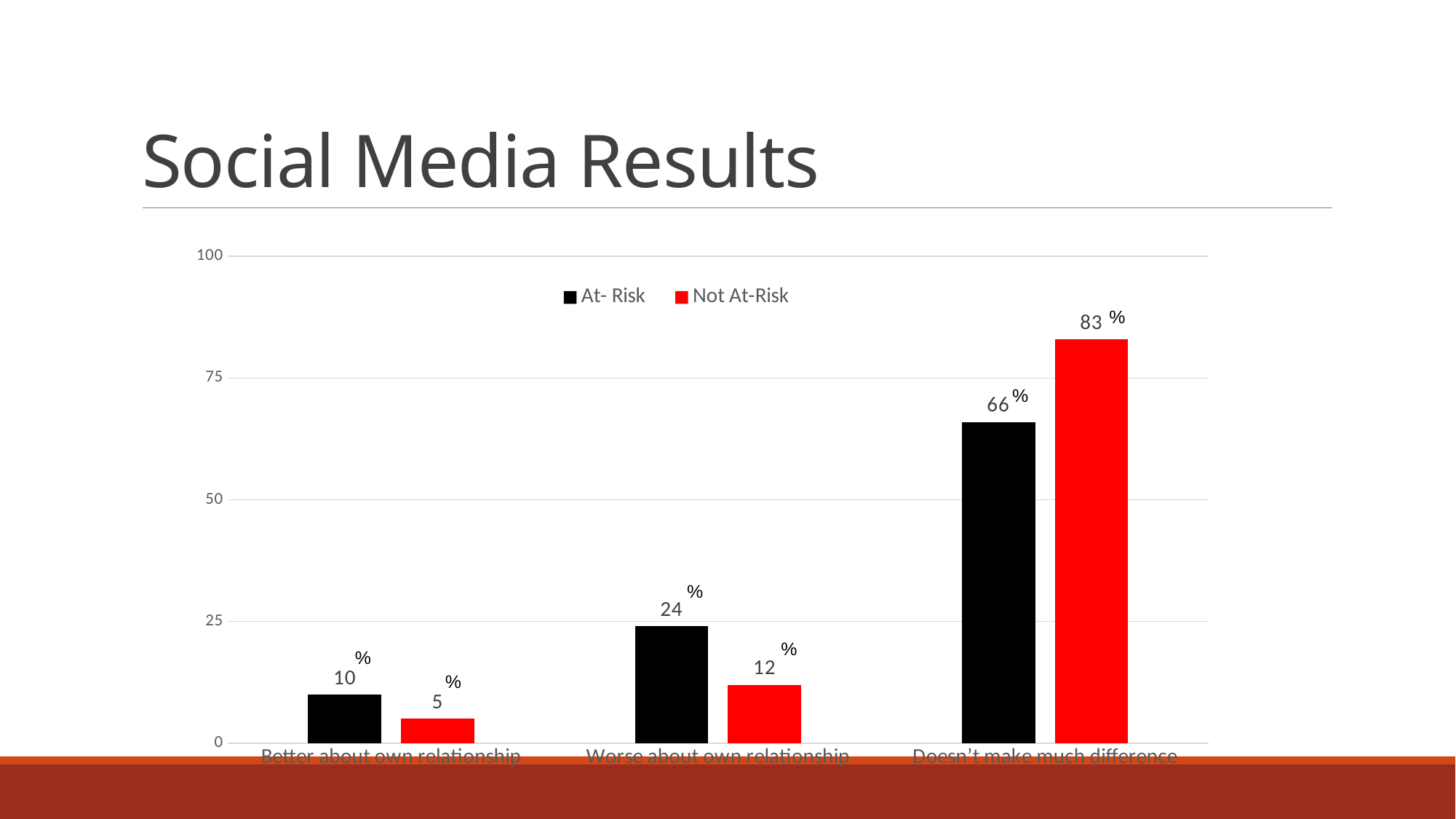
How many categories are shown on the x axis? 3 How many series does the legend list? 2 What is the Not At-Risk value for "Better about own relationship"? 5% What is the At-Risk value for "Worse about own relationship"? 24% For "Worse about own relationship", which series has the larger value, At-Risk or Not At-Risk? At-Risk Which category has the highest At-Risk value? Doesn't make much difference What colour represents the Not At-Risk series? Red Which category has the lowest Not At-Risk value? Better about own relationship Is the At-Risk value for "Doesn't make much difference" greater or less than 50? greater What is the difference between the Not At-Risk and At-Risk values for "Doesn't make much difference"? 17% What kind of chart is shown on the slide? Bar chart What is the Not At-Risk value for "Doesn't make much difference"? 83%